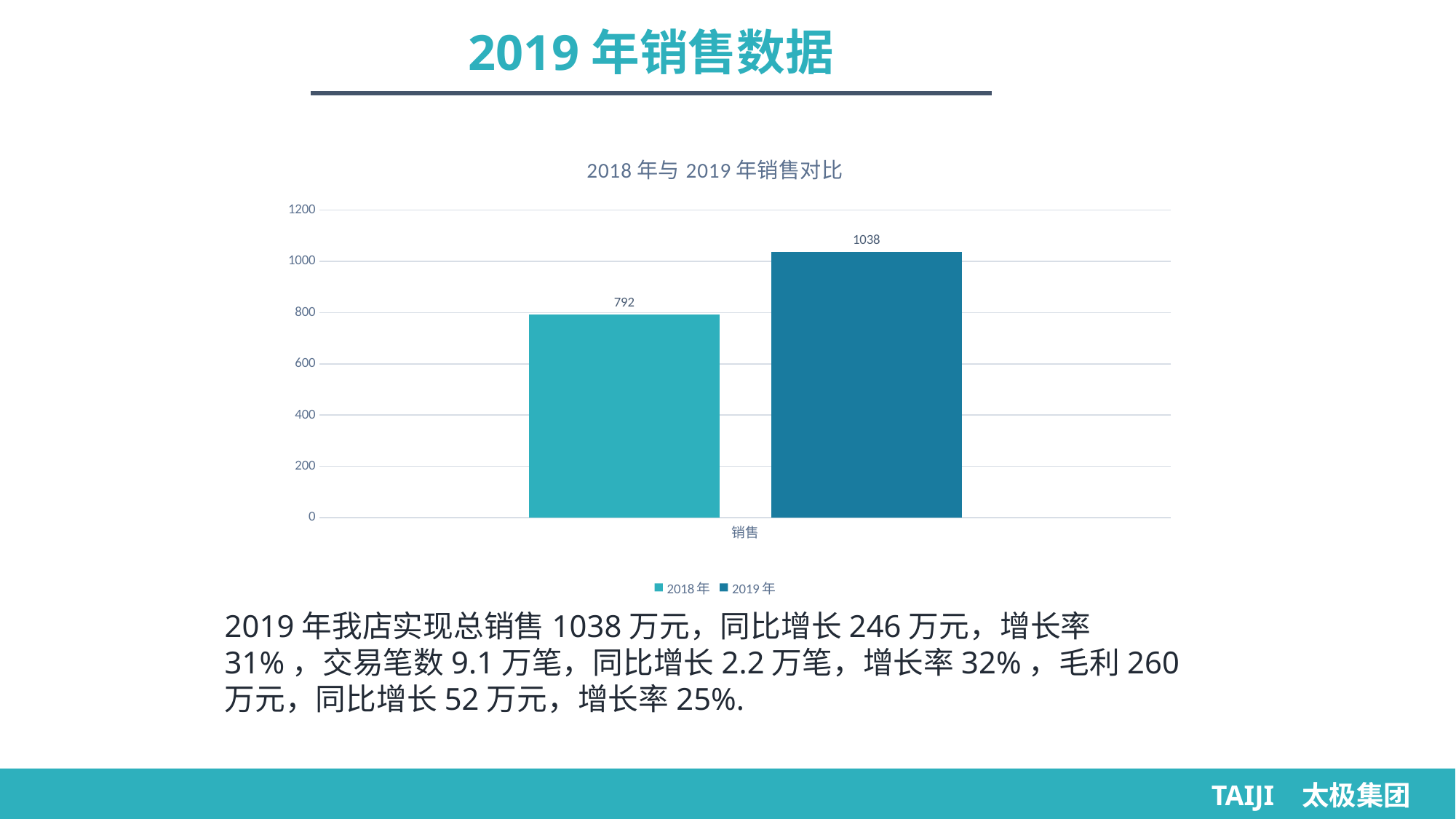
Is the value for 2018 年 greater or less than 800? less Is the value for 2019 年 greater or less than 1000? greater What is the value for 2018 年 in the 销售 category? 792 How many series does the legend list? 2 Which series has the lowest value in the chart? 2018 年 What kind of chart is shown on the slide? Bar chart How many categories are shown on the x axis? 1 What is the value for 2019 年 in the 销售 category? 1038 What is the difference between the 2019 年 and 2018 年 values for 销售? 246 Which series has the higher value for 销售, 2018 年 or 2019 年? 2019 年 What is the label of the category on the x axis? 销售 What is the title of the chart? 2018 年与 2019 年销售对比